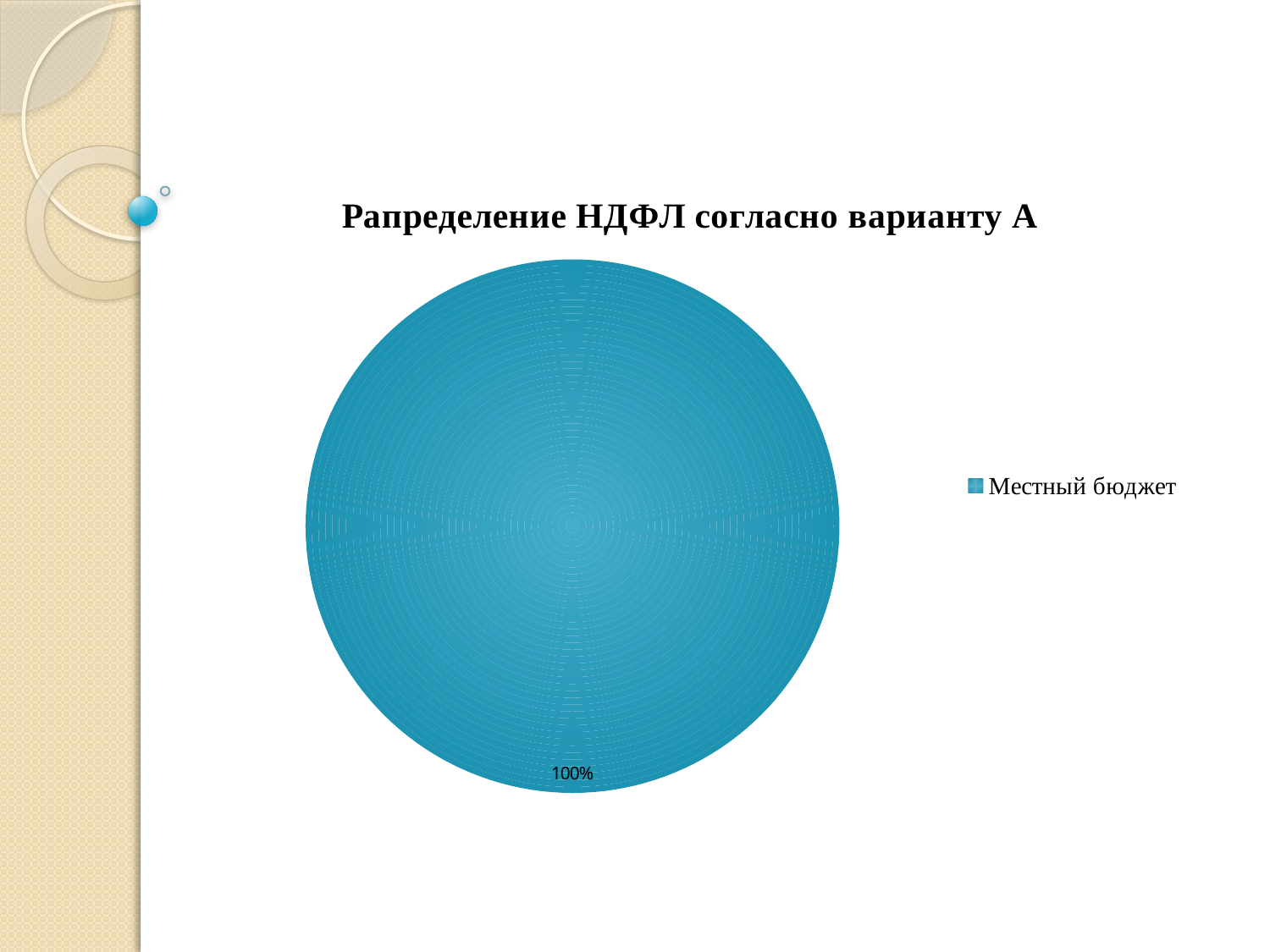
What kind of chart is shown on the slide? pie chart What value is printed as the data label on the pie? 100% What is the title of the chart? Рапределение НДФЛ согласно варианту А How many slices does the pie chart have? 1 How many entries does the legend list? 1 What share of the pie does Местный бюджет have? 100% What is the label of the only legend entry? Местный бюджет